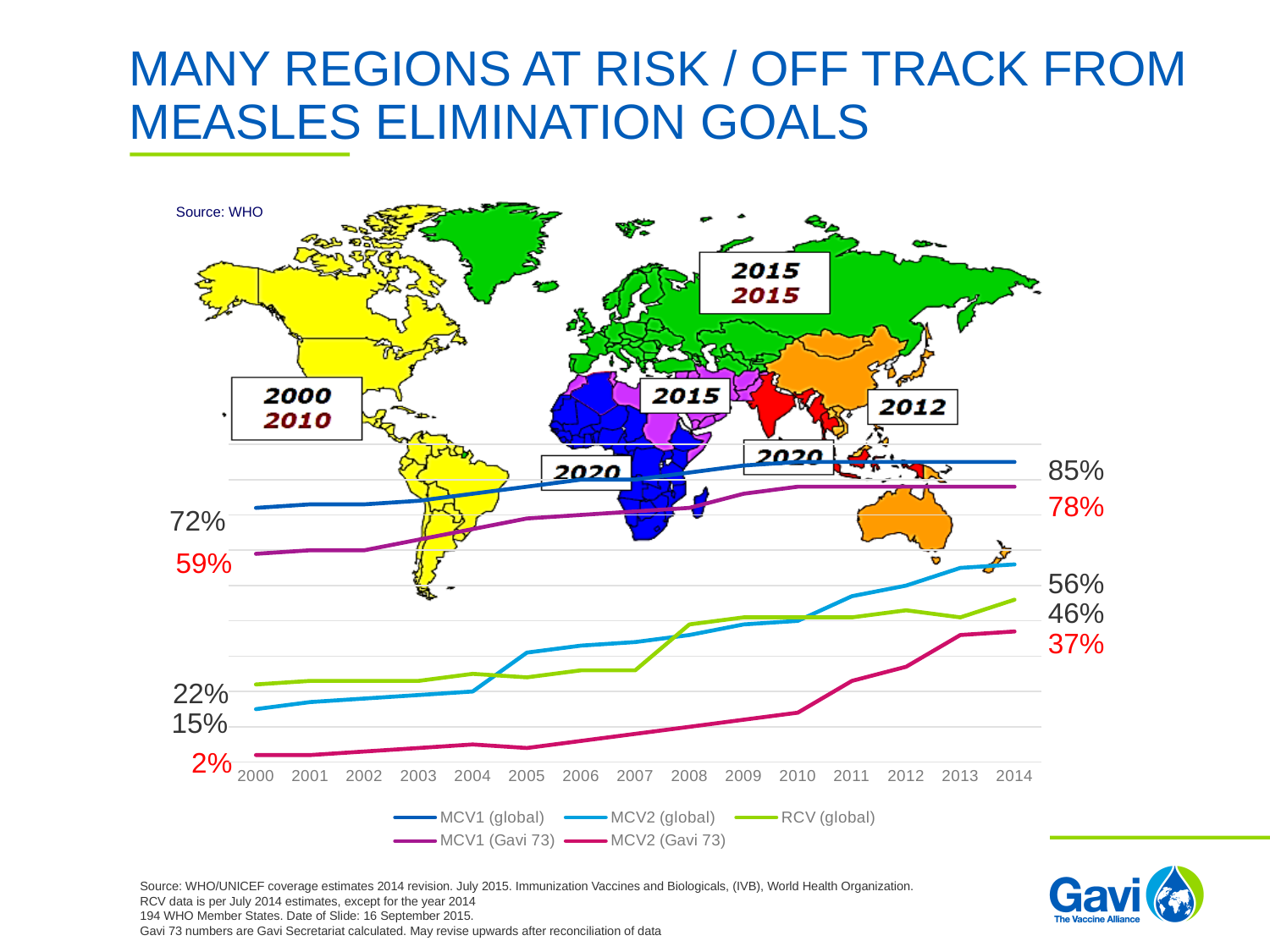
Does the MCV2 (global) coverage rise or fall from 2000 to 2014? Rise By how many percentage points did MCV1 (global) coverage increase from 2000 (72%) to 2014 (85%)? 13 Which series has the highest value in 2014? MCV1 (global) What is the MCV1 (global) coverage value labelled for 2014? 85% What is the MCV2 (Gavi 73) coverage value labelled for 2000? 2% How many series does the chart legend list? 5 What type of chart is shown on the slide? Line chart What is the MCV1 (Gavi 73) coverage value labelled for 2000? 59% What is the MCV2 (Gavi 73) coverage value labelled for 2014? 37% Which series has the lowest value in 2000? MCV2 (Gavi 73) What is the MCV1 (global) coverage value labelled for 2000? 72% How many years are shown on the x axis of the chart? 15